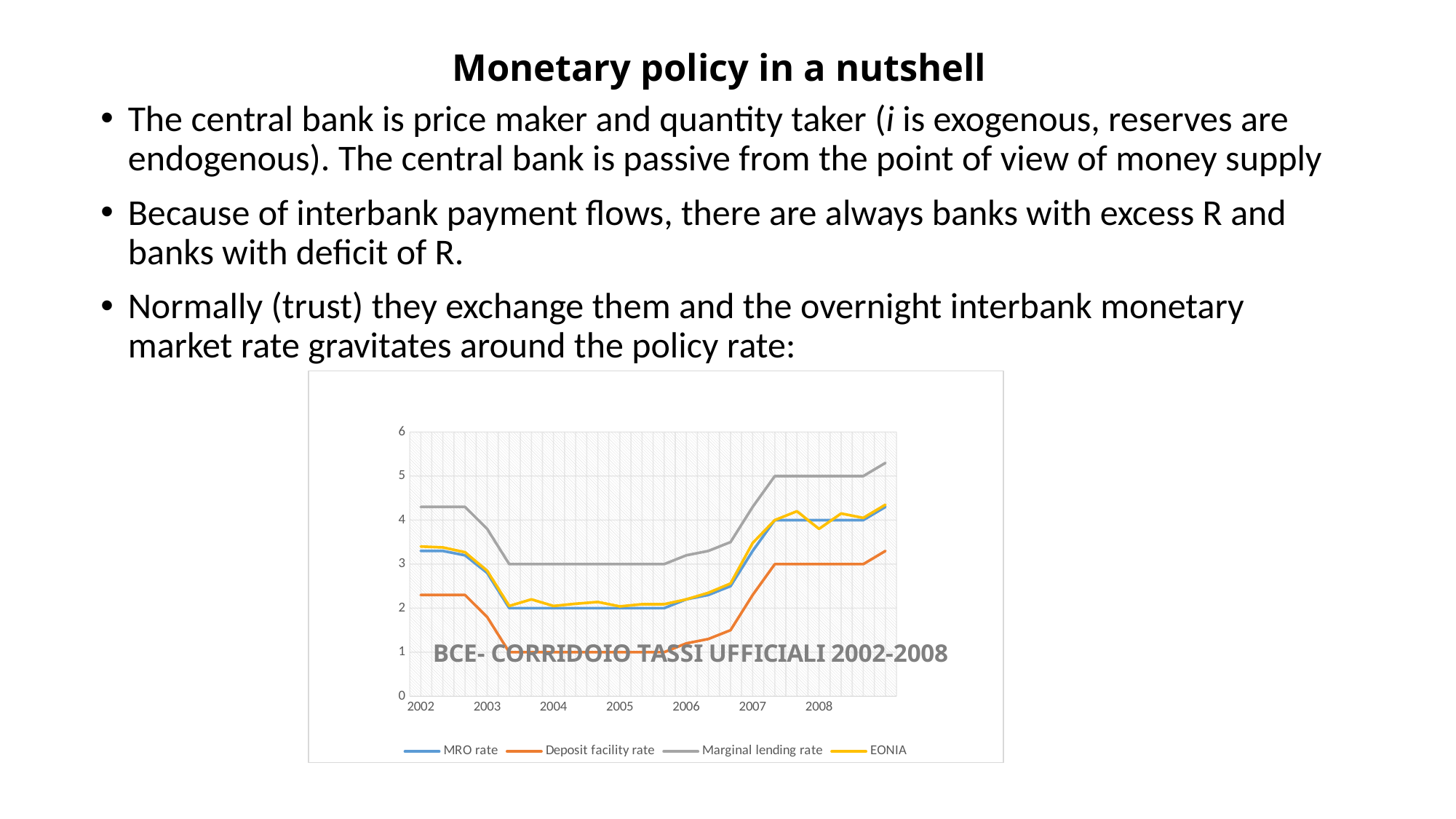
In 2006, which is larger: the Marginal lending rate or the Deposit facility rate? Marginal lending rate Is the value of the Marginal lending rate in 2002 greater or less than 4? greater Is the value of the Deposit facility rate in 2002 greater or less than 2? greater What kind of chart is shown on the slide? Line chart What is the title of the chart? BCE- CORRIDOIO TASSI UFFICIALI 2002-2008 Is the value of EONIA in 2008 greater or less than 3? greater Which series has the highest values across the whole period? Marginal lending rate How many series does the chart legend list? 4 Does the Marginal lending rate rise or fall between 2004 and 2008? Rise Which series is plotted in orange? Deposit facility rate Which series has the lowest values across the whole period? Deposit facility rate